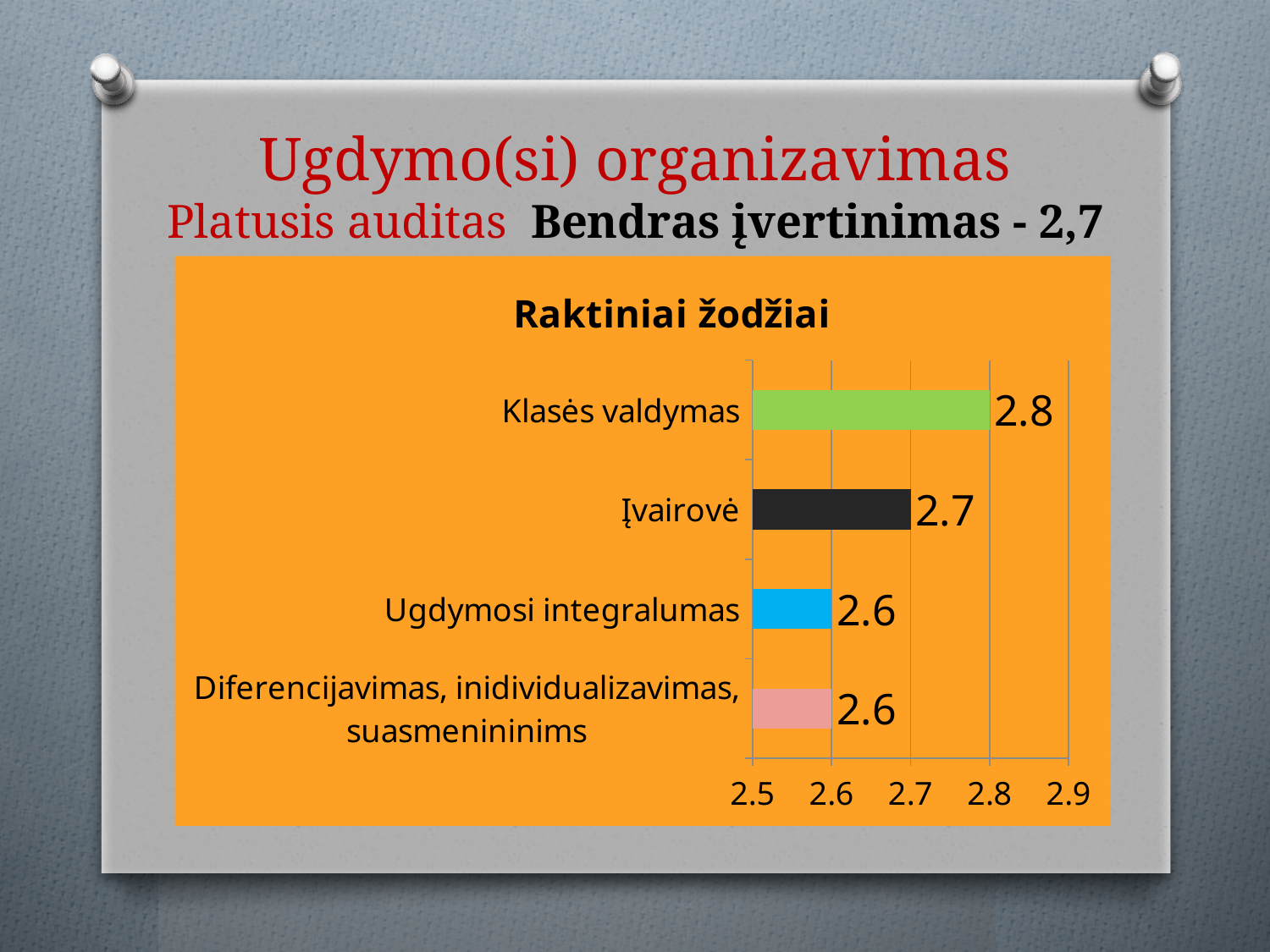
What is the value for Įvairovė? 2.7 What kind of chart is shown on the slide? bar chart What is the value for Klasės valdymas? 2.8 What is the title of the chart? Raktiniai žodžiai What is the value for Ugdymosi integralumas? 2.6 What is the difference between the values for Klasės valdymas and Įvairovė? 0.1 Is the value for Klasės valdymas greater or less than 2.7? greater Which is larger, the value for Įvairovė or the value for Ugdymosi integralumas? Įvairovė How many categories are shown in the chart? 4 What is the value for Diferencijavimas, inidividualizavimas, suasmenininims? 2.6 Which category has the highest value? Klasės valdymas What is the difference between the values for Klasės valdymas and Ugdymosi integralumas? 0.2